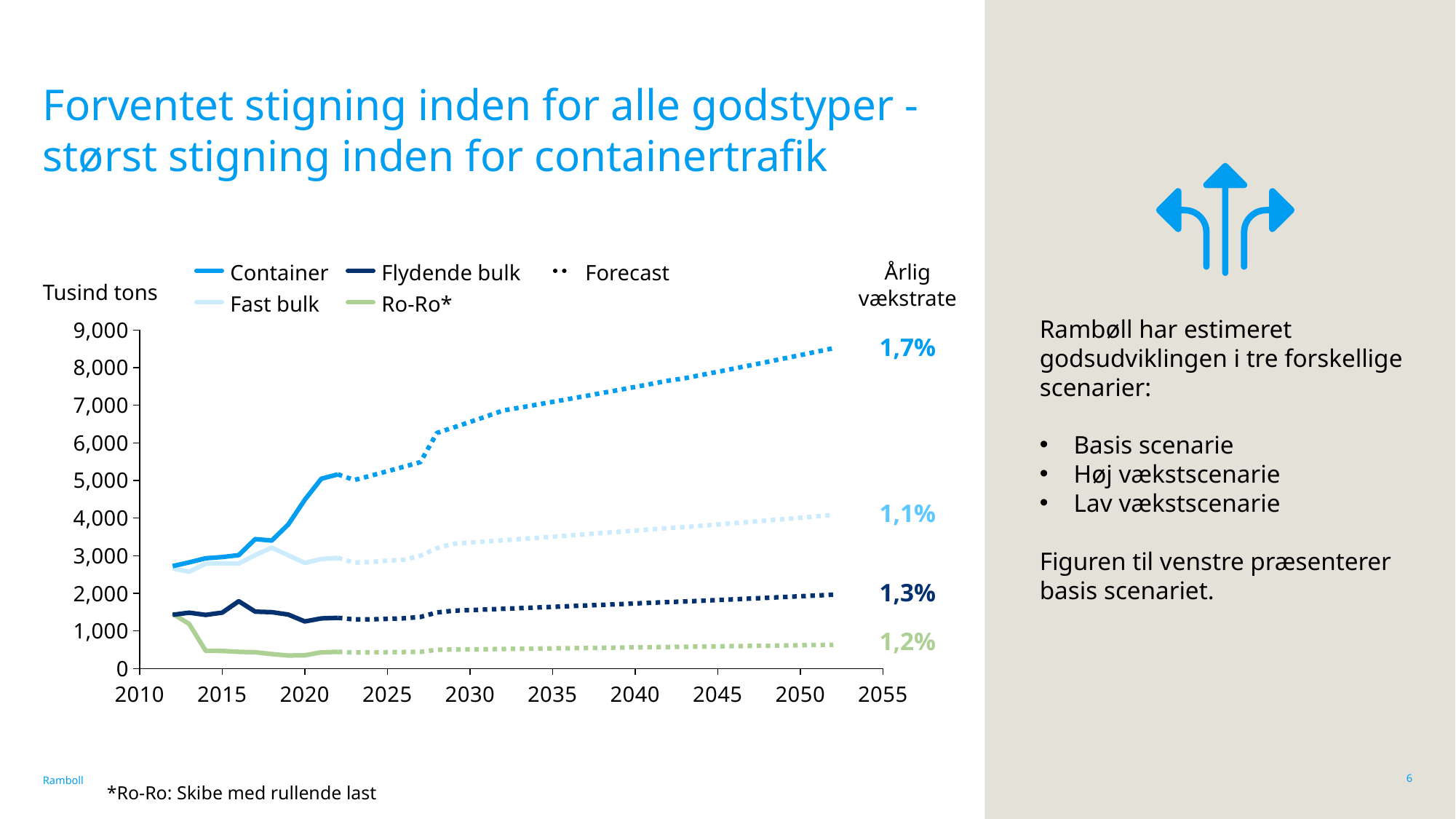
What is the annual growth rate shown for Flydende bulk? 1,3% Is the Ro-Ro* value in 2020 greater or less than 1,000? less Which series has the lowest annual growth rate? Fast bulk What kind of chart is shown on the slide? Line chart What is the difference between the annual growth rates of Container and Fast bulk? 0,6% What is the annual growth rate shown for Ro-Ro*? 1,2% What does the dotted line style represent according to the legend? Forecast What is the annual growth rate (Årlig vækstrate) shown for Container? 1,7% How many entries does the chart legend list? 5 Which series has the highest annual growth rate? Container Is the Container value around 2050 greater or less than 8,000? greater What is the annual growth rate shown for Fast bulk? 1,1%